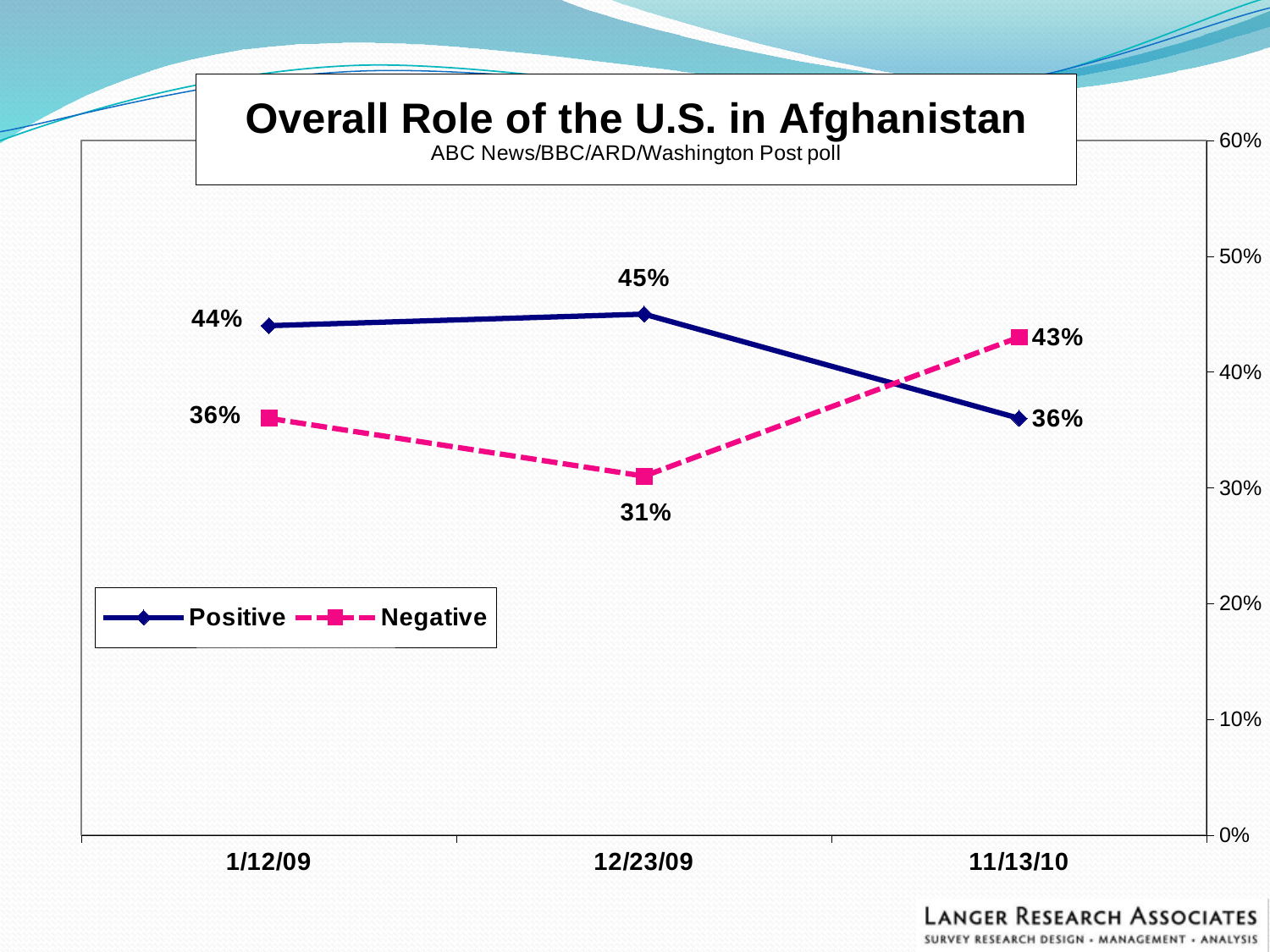
On 11/13/10, which is larger, Positive or Negative? Negative On which date is the Negative series lowest? 12/23/09 What kind of chart is shown? Line chart How many dates are plotted on the x axis? 3 Does the Negative series rise or fall between 12/23/09 and 11/13/10? Rise What is the difference between the Positive and Negative values on 12/23/09? 14 percentage points Is the Negative value on 12/23/09 greater or less than 40%? less What is the Negative value on 1/12/09? 36% On which date is the Positive series highest? 12/23/09 How many series does the legend list? 2 What is the Positive value on 12/23/09? 45% What is the Negative value on 11/13/10? 43%